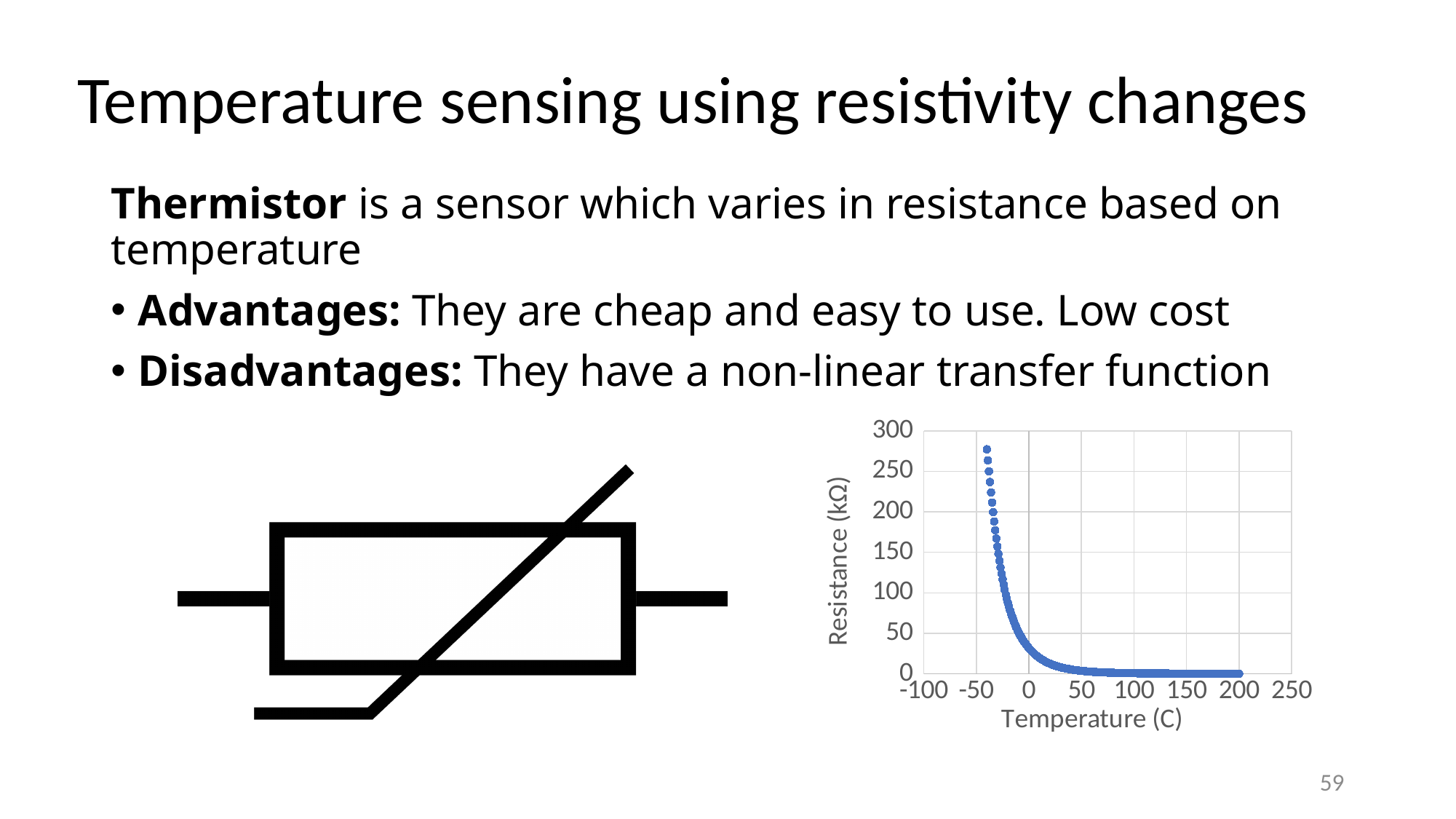
Is the resistance value at the lowest plotted temperature (around -40 C) greater or less than 250 kΩ? greater Do the plotted resistance values rise or fall as temperature increases along the x axis? fall Which has the larger resistance, the point at -40 C or the point at 50 C? -40 C Is the resistance value at 200 C greater or less than 50 kΩ? less What kind of chart is shown on the slide? scatter chart What is the label of the x axis of the chart? Temperature (C) Is the resistance value at 0 C greater or less than 100 kΩ? less What is the label of the y axis of the chart? Resistance (kΩ) At which end of the temperature range is the resistance highest, the low-temperature end or the high-temperature end? low-temperature end